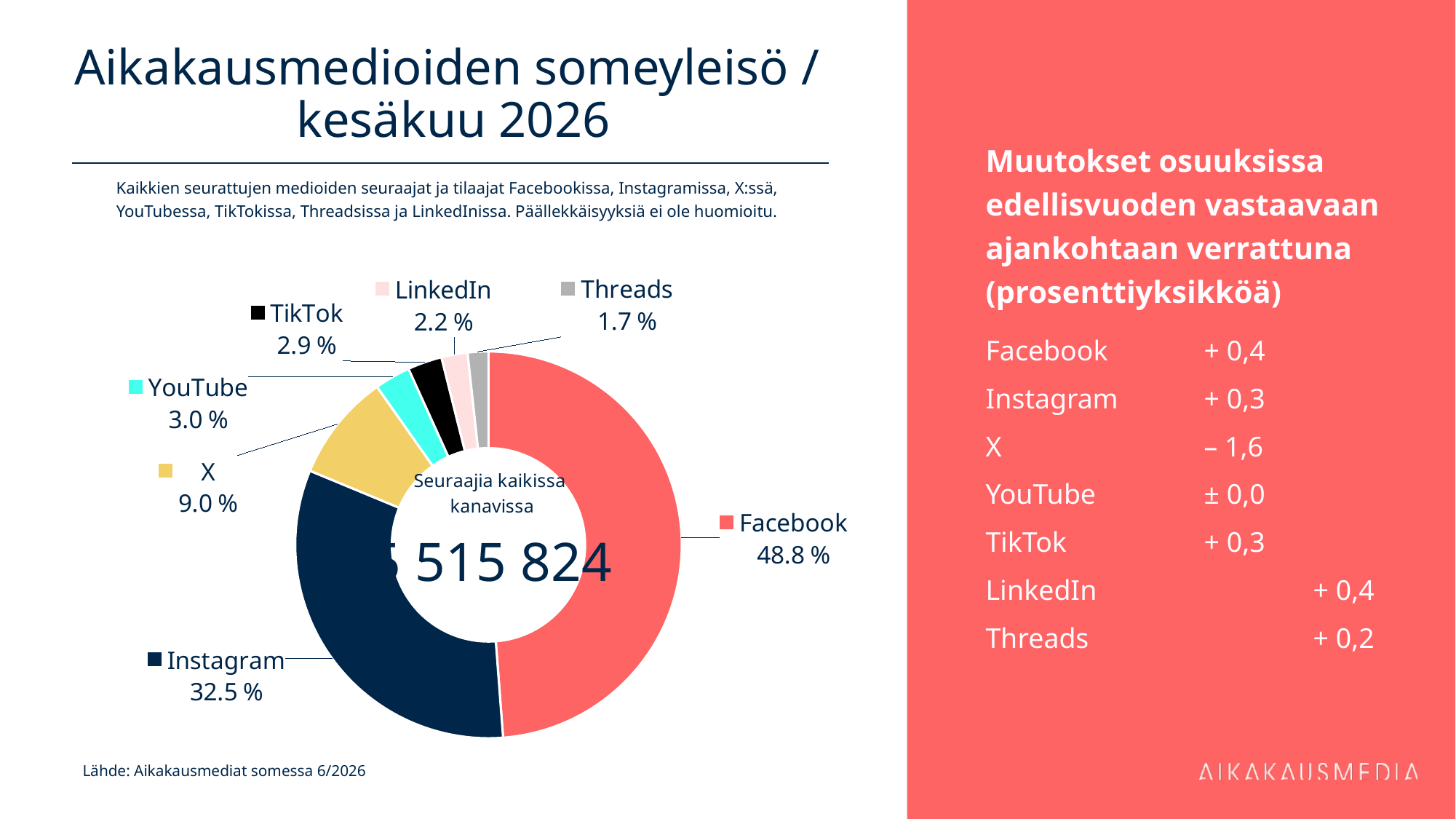
What share of the social media audience does Facebook have? 48.8 % How many percentage points larger is Facebook's share than Instagram's? 16.3 percentage points Which platform has the largest slice of the chart? Facebook How many platforms (slices) are shown in the chart? 7 What is the value shown for X in the chart? 9.0 % Which platform has the smallest slice of the chart? Threads What is the difference between the shares of X and YouTube? 6.0 percentage points Which is larger, the share of Instagram or the share of X? Instagram What share does Instagram have in the chart? 32.5 % What kind of chart is shown on the slide? Pie chart (donut) What percentage is shown for LinkedIn? 2.2 % What colour is the Facebook slice in the chart? Red (coral)